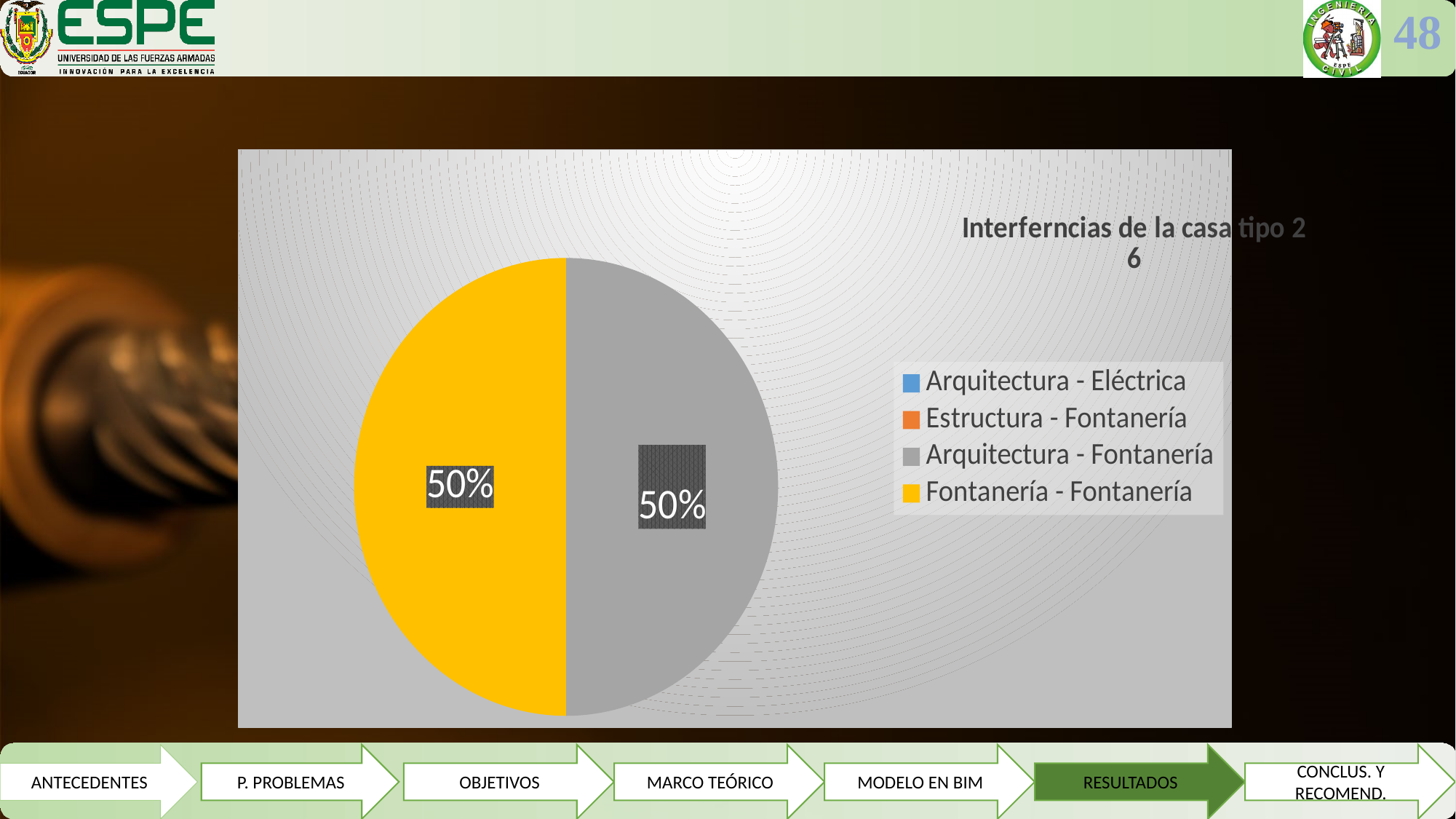
What is the difference between the share of Fontanería - Fontanería and the share of Arquitectura - Fontanería? 0% Which legend entry is shown in gray? Arquitectura - Fontanería Is the share for Arquitectura - Fontanería larger, smaller, or equal to the share for Fontanería - Fontanería? equal How many entries does the chart legend list? 4 How many slices are visible in the pie chart? 2 What is the title of the chart? Interferncias de la casa tipo 2 6 What kind of chart is shown on the slide? pie chart What share of the pie does Fontanería - Fontanería represent? 50% What share of the pie does Arquitectura - Fontanería represent? 50% Which colour represents Fontanería - Fontanería in the pie chart? yellow What is the combined share of the Arquitectura - Fontanería and Fontanería - Fontanería slices? 100%